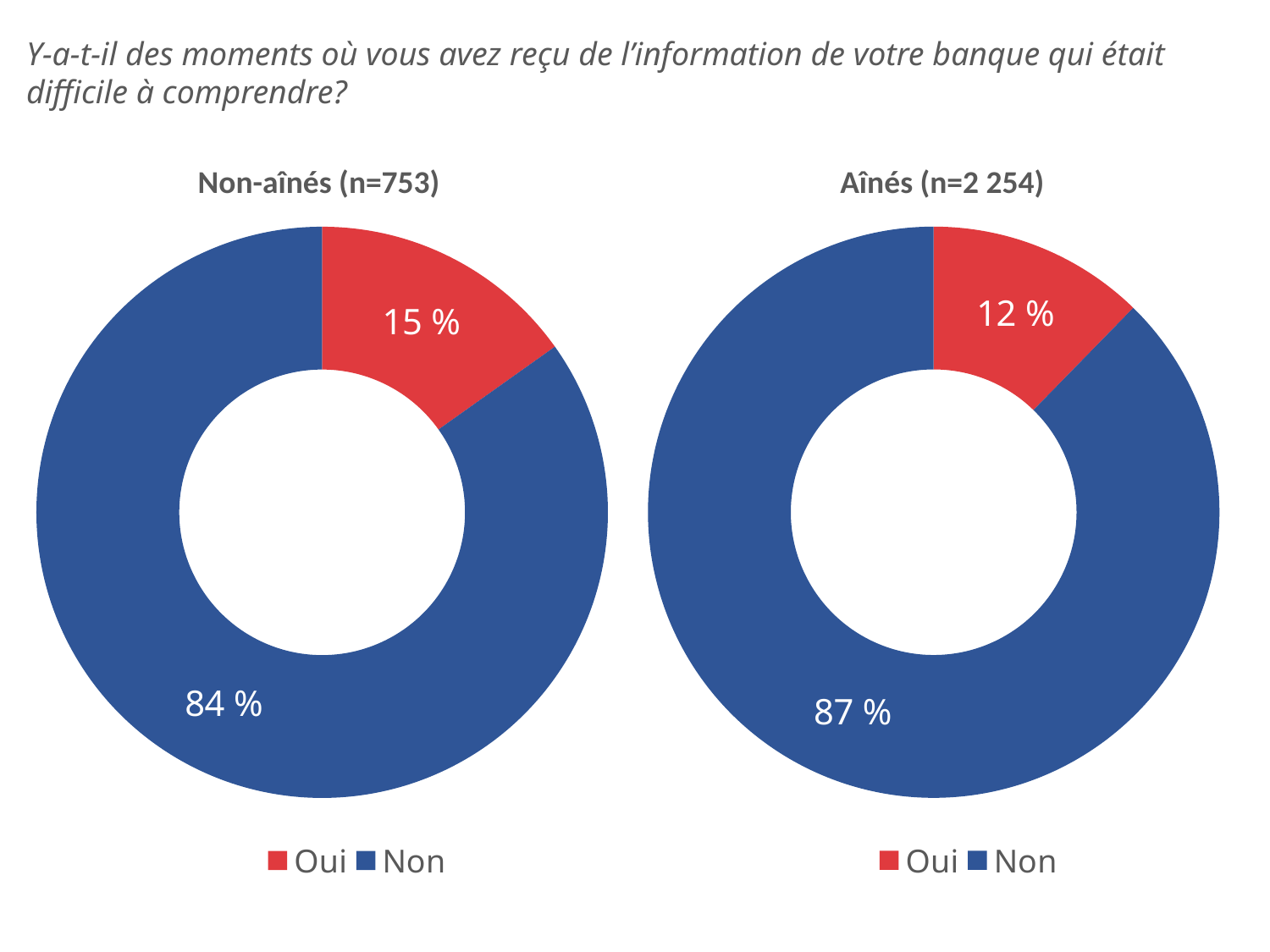
In the 'Non-aînés (n=753)' chart, which response has the smallest share? Oui In the 'Aînés (n=2 254)' chart, which response has the largest share? Non In the 'Non-aînés (n=753)' chart, what percentage answered 'Oui'? 15 % In the 'Aînés (n=2 254)' chart, what percentage answered 'Non'? 87 % What kind of chart is the 'Non-aînés (n=753)' chart? Doughnut chart In the 'Non-aînés (n=753)' chart, what colour represents 'Oui'? Red What are the legend entries in the 'Aînés (n=2 254)' chart? Oui, Non What is the difference between the 'Non' share in the 'Aînés (n=2 254)' chart and the 'Non' share in the 'Non-aînés (n=753)' chart? 3 % In the 'Non-aînés (n=753)' chart, what percentage answered 'Non'? 84 % In the 'Aînés (n=2 254)' chart, what percentage answered 'Oui'? 12 % Which chart has the larger 'Oui' share, 'Non-aînés (n=753)' or 'Aînés (n=2 254)'? Non-aînés (n=753) How many categories does the 'Aînés (n=2 254)' chart show? 2